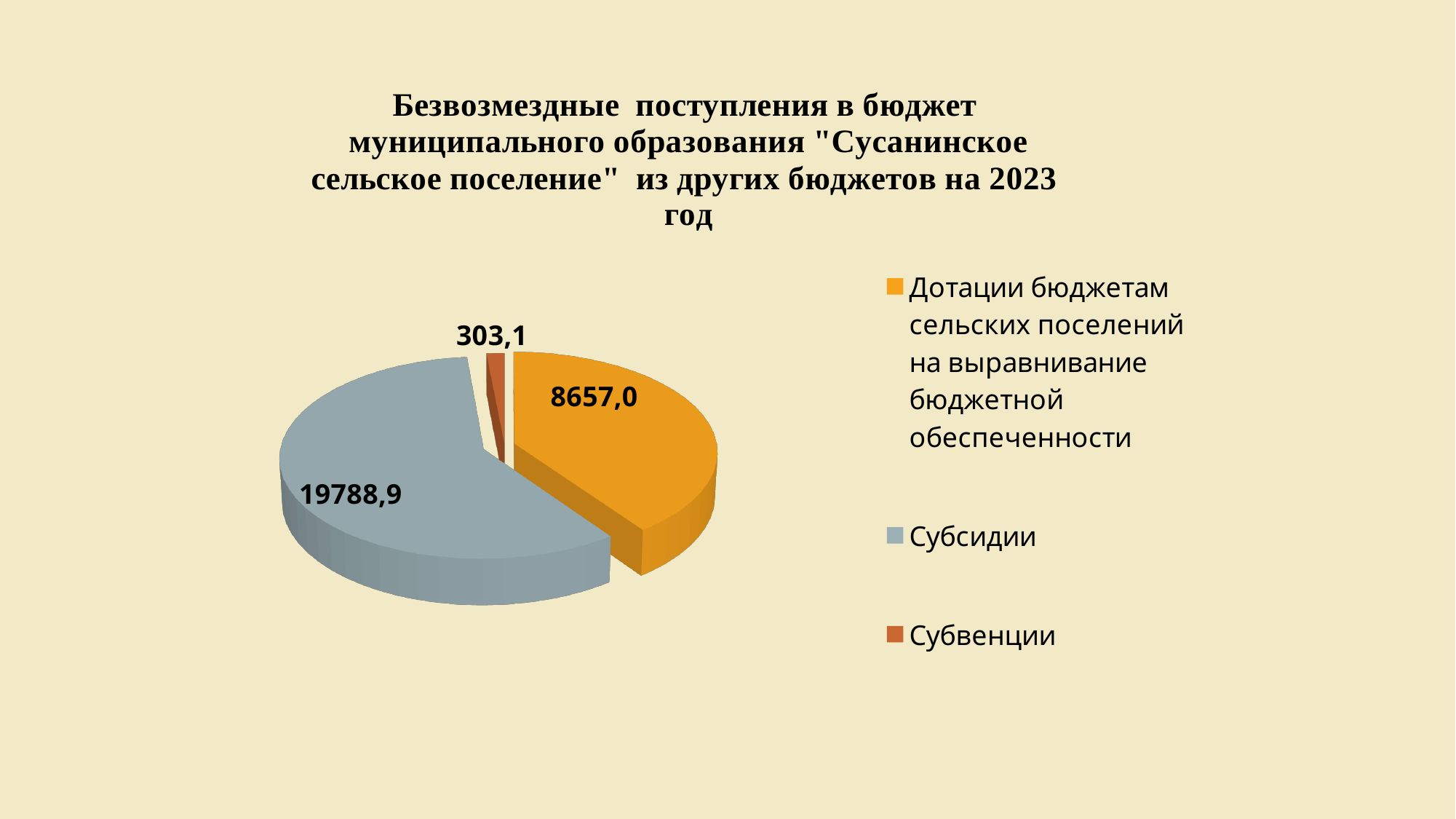
What is the total of all slices in the pie chart? 28749,0 What is the value for Дотации бюджетам сельских поселений на выравнивание бюджетной обеспеченности? 8657,0 Which is larger: the value for Субсидии or the value for Дотации бюджетам сельских поселений на выравнивание бюджетной обеспеченности? Субсидии Which category has the largest slice of the pie? Субсидии What is the value for Субвенции? 303,1 What type of chart is shown on the slide? Pie chart What is the value for Субсидии? 19788,9 Which colour represents Субвенции in the legend? Red-brown (dark orange) What is the difference between the values for Субсидии and Дотации бюджетам сельских поселений на выравнивание бюджетной обеспеченности? 11131,9 Which category has the smallest slice of the pie? Субвенции What is the difference between the values for Дотации бюджетам сельских поселений на выравнивание бюджетной обеспеченности and Субвенции? 8353,9 How many categories does the pie chart have? 3